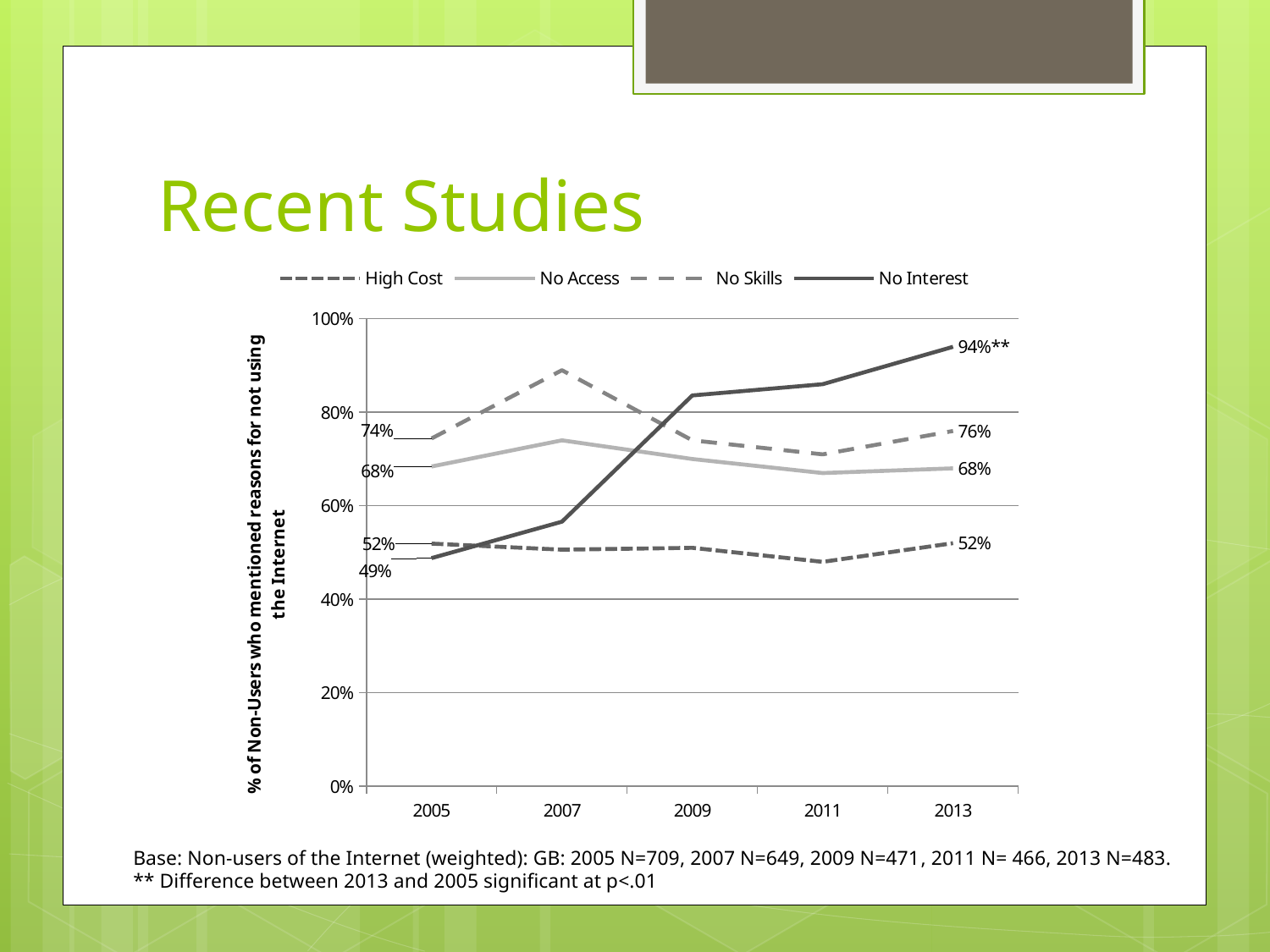
What is the value for No Interest in 2005? 49% In 2013, which is higher: No Skills or No Access? No Skills How many years are shown on the x axis? 5 By how many percentage points did No Interest increase from 2005 to 2013? 45 percentage points Which series has the highest value in 2013? No Interest How many series does the legend list? 4 What is the value for High Cost in 2013? 52% What is the value for No Skills in 2013? 76% What is the value for No Access in 2005? 68% Is the value for No Skills in 2007 greater or less than 80%? greater What kind of chart is shown on the slide? line chart What is the value for No Interest in 2013? 94%